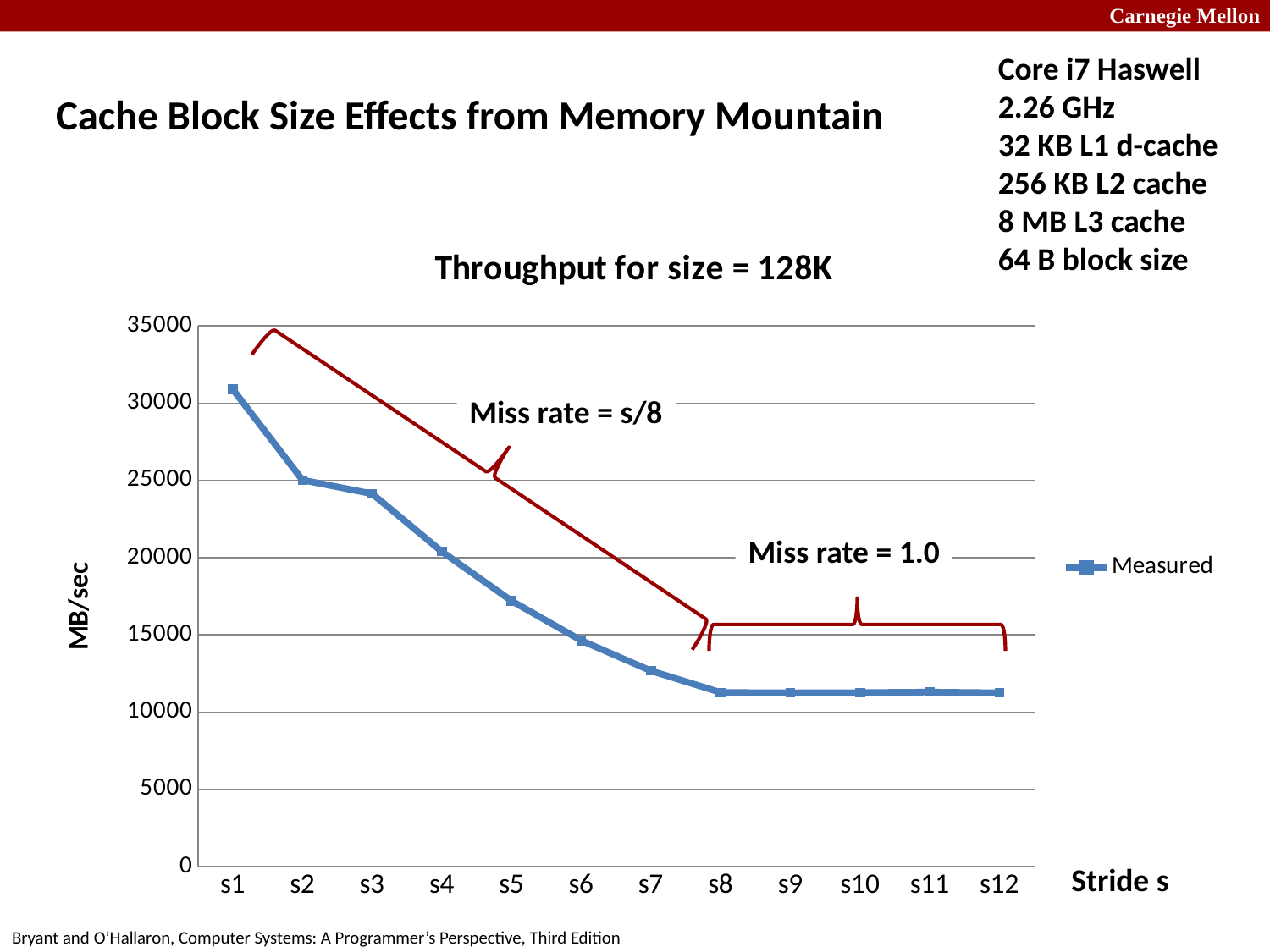
What is the title of the chart? Throughput for size = 128K Is the value for s1 greater or less than 30000? greater Is the value for s8 greater or less than 10000? greater Is the value for s7 greater or less than 15000? less What kind of chart is shown on the slide? line chart Do the measured values rise or fall as the stride increases from s1 to s8? fall Which stride has the highest measured throughput? s1 How many stride categories are plotted along the x axis? 12 Which has the larger measured throughput, s1 or s8? s1 What is the label on the y axis? MB/sec How many series does the legend list? 1